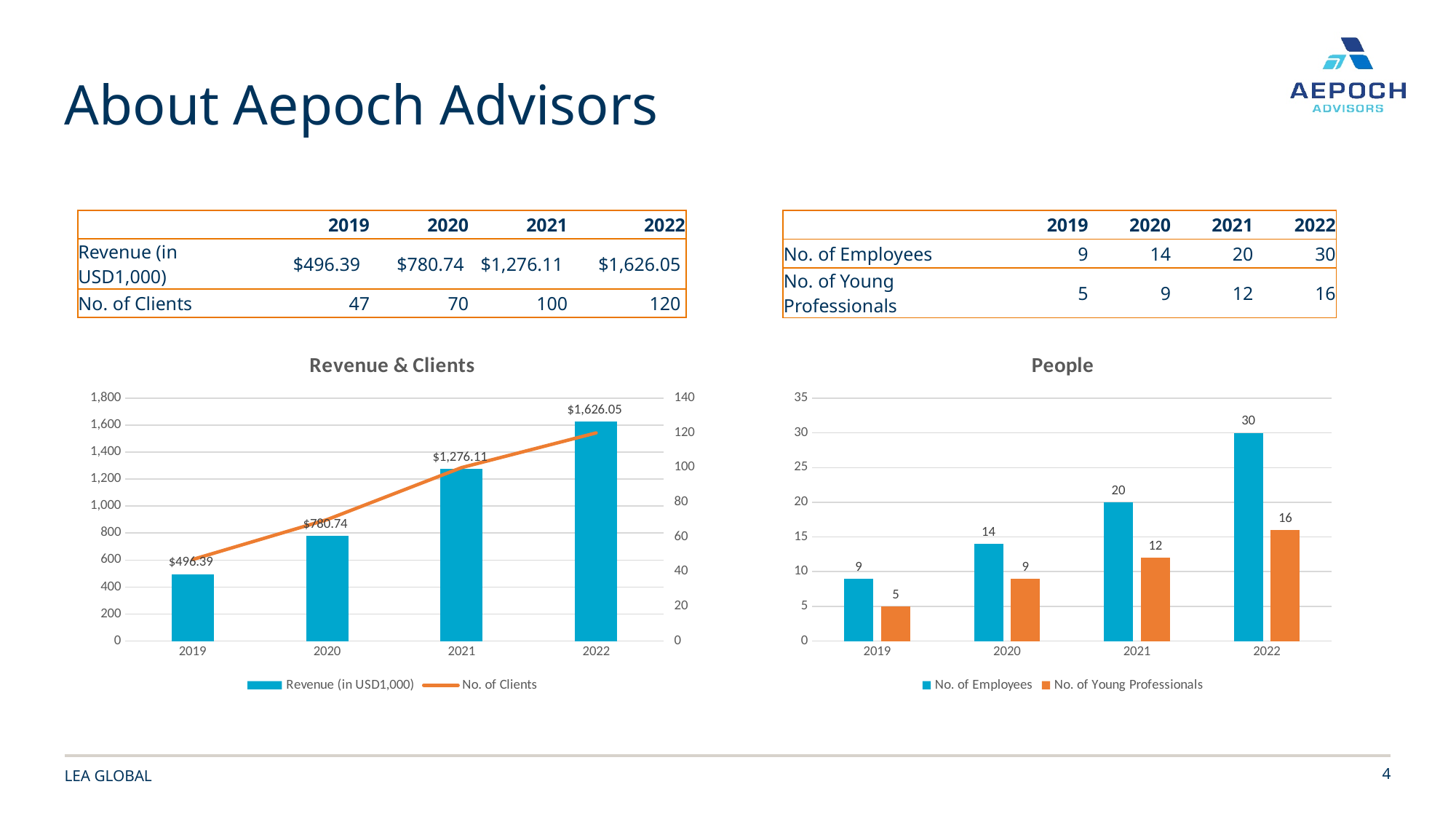
In the Revenue & Clients chart, does revenue rise or fall from 2019 to 2022? rise In the People chart, which is larger in 2020: No. of Employees or No. of Young Professionals? No. of Employees What kind of chart is the People chart? bar chart In the Revenue & Clients chart, which year has the lowest revenue? 2019 In the People chart, what is the No. of Young Professionals value for 2022? 16 In the Revenue & Clients chart, is the No. of Clients value for 2022 greater or less than 100? greater In the People chart, what is the difference between No. of Employees and No. of Young Professionals in 2022? 14 In the Revenue & Clients chart, what is the revenue value for 2019? $496.39 In the Revenue & Clients chart, what is the revenue value for 2022? $1,626.05 How many series does the legend of the Revenue & Clients chart list? 2 In the People chart, what is the No. of Employees value for 2021? 20 In the People chart, which year has the highest No. of Employees? 2022